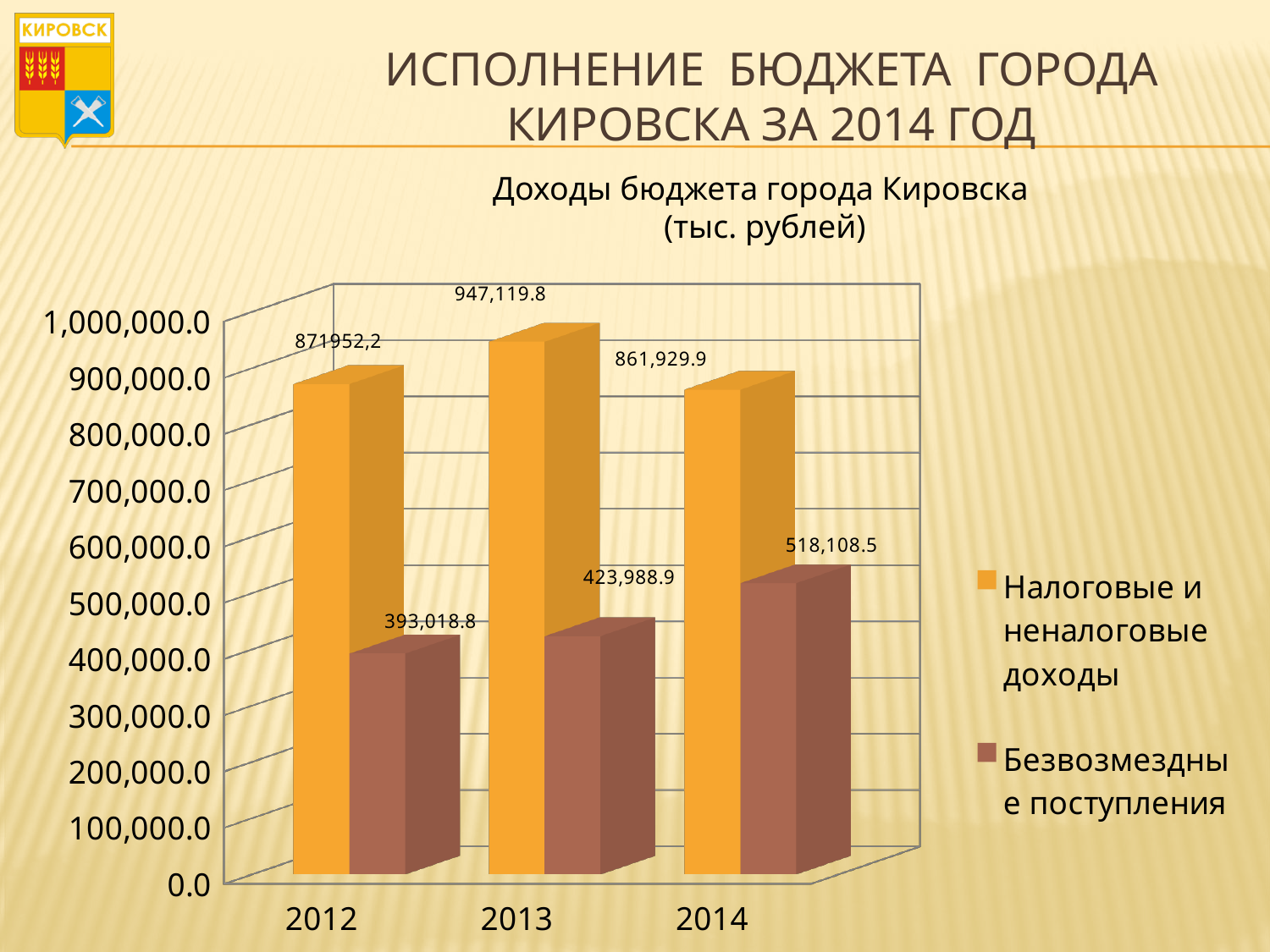
What is the value of Налоговые и неналоговые доходы for 2013? 947,119.8 By how much did Безвозмездные поступления increase from 2013 to 2014? 94,119.6 Which is larger in 2014: Налоговые и неналоговые доходы or Безвозмездные поступления? Налоговые и неналоговые доходы What is the value of Безвозмездные поступления for 2014? 518,108.5 What type of chart is shown on the slide? bar chart What is the value of Безвозмездные поступления for 2012? 393,018.8 In which year is Налоговые и неналоговые доходы highest? 2013 Do the values for Безвозмездные поступления rise or fall from 2012 to 2014? rise In which year is Безвозмездные поступления lowest? 2012 What is the chart's title? Доходы бюджета города Кировска (тыс. рублей) How many years are shown on the x axis? 3 How many series does the legend list? 2